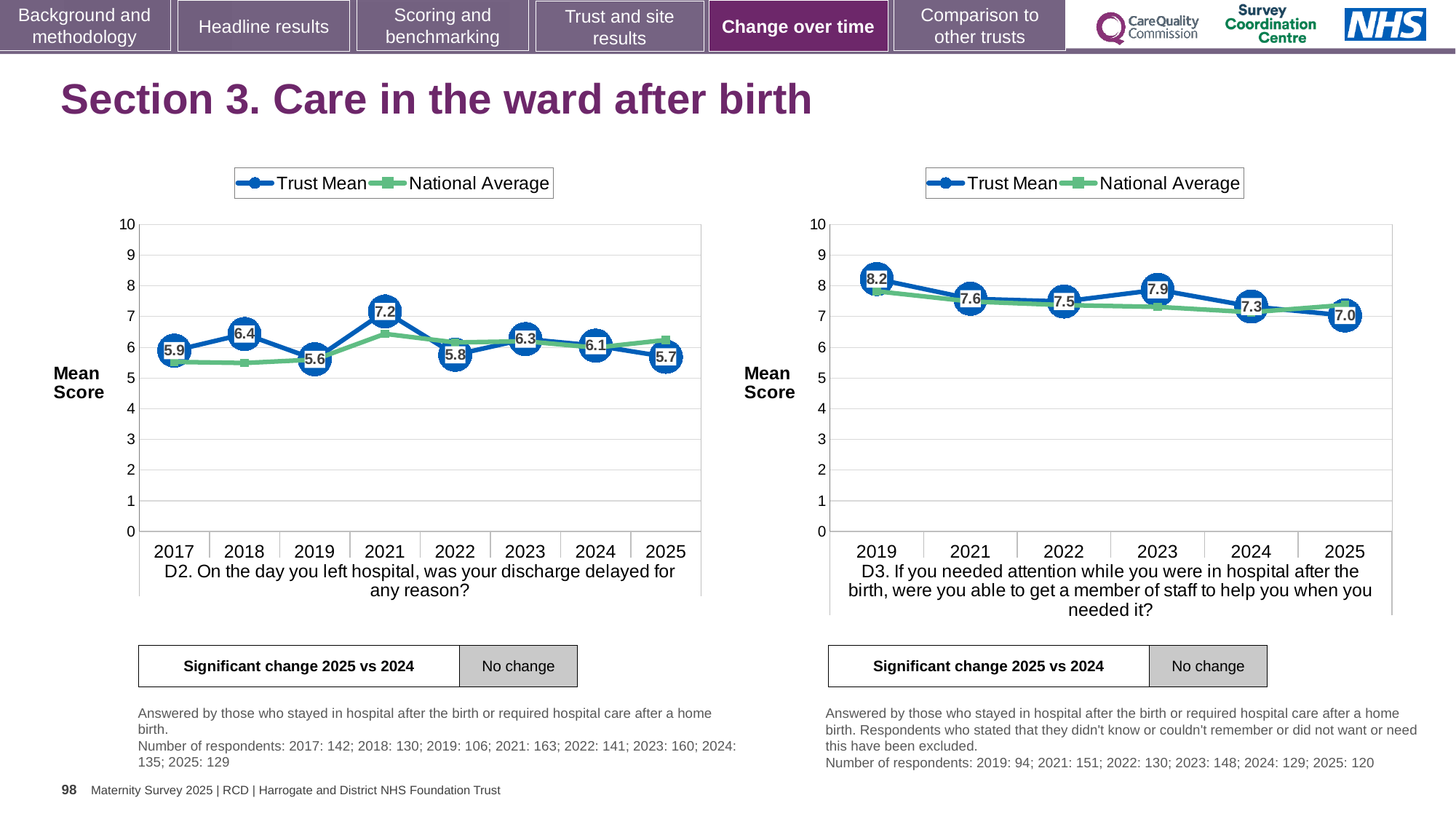
In the left chart (D2, discharge delayed), what is the Trust Mean for 2025? 5.7 What type of chart is the left chart (D2, discharge delayed)? line chart In the right chart (D3, able to get a member of staff), is the Trust Mean for 2023 higher or lower than for 2024? higher In the left chart (D2, discharge delayed), how many years are plotted on the x axis? 8 In the right chart (D3, able to get a member of staff), what is the difference between the Trust Mean in 2019 and in 2025? 1.2 In the left chart (D2, discharge delayed), what is the difference between the Trust Mean in 2021 and in 2022? 1.4 In the right chart (D3, able to get a member of staff), which year has the lowest Trust Mean? 2025 In the left chart (D2, discharge delayed), which year has the lowest Trust Mean? 2019 In the left chart (D2, discharge delayed), which year has the highest Trust Mean? 2021 In the left chart (D2, discharge delayed), what is the Trust Mean for 2021? 7.2 In the right chart (D3, able to get a member of staff), what is the Trust Mean for 2019? 8.2 In the right chart (D3, able to get a member of staff), how many series does the legend list? 2